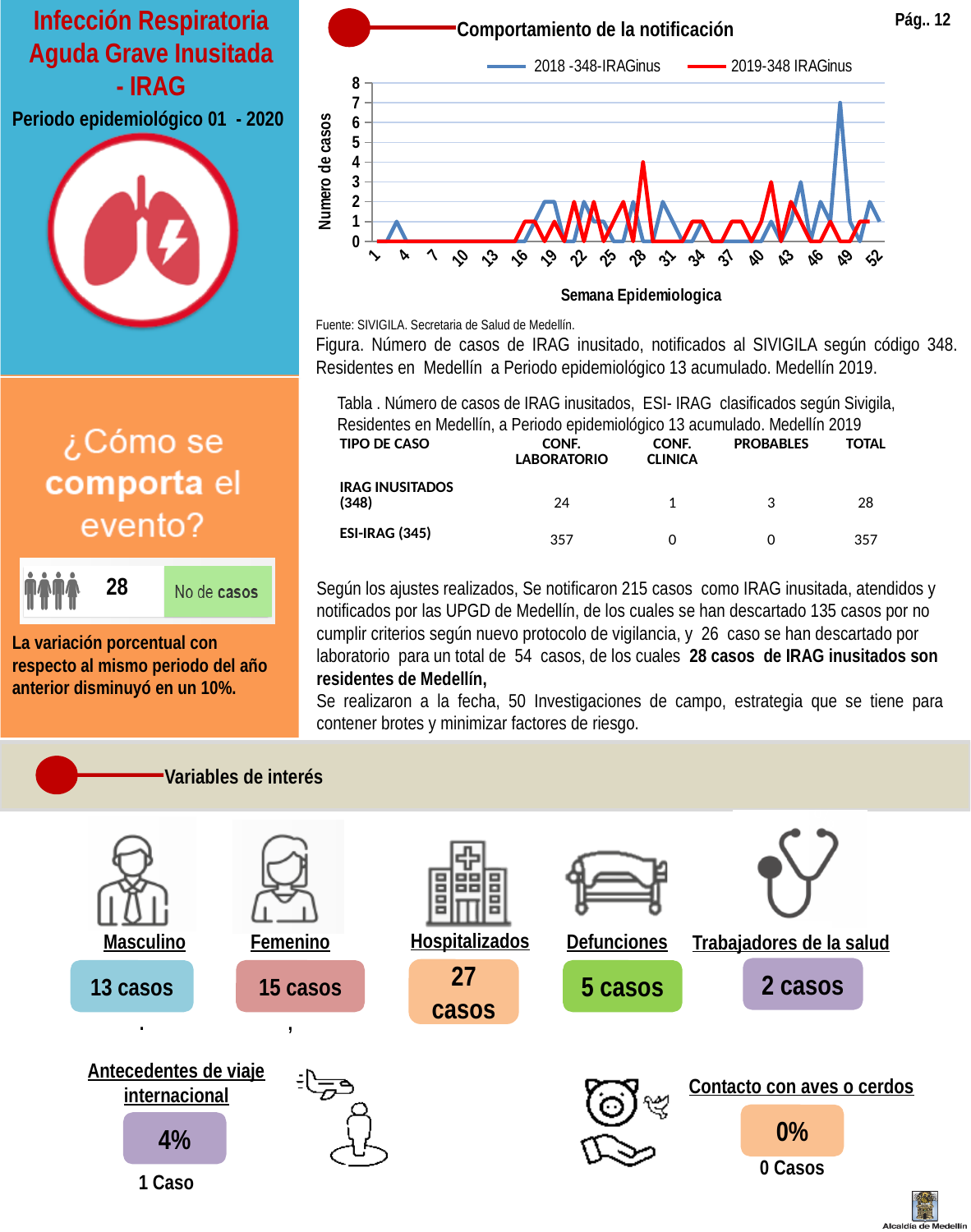
In the 'Comportamiento de la notificación' chart, what is the difference between the peak value of the 2018 series (7) and the peak value of the 2019 series (4)? 3 What kind of chart is 'Comportamiento de la notificación'? line chart How many series does the legend of the 'Comportamiento de la notificación' chart list? 2 In the 'Comportamiento de la notificación' chart, which series reaches the highest number of cases in any week? 2018 -348-IRAGinus In the 'Comportamiento de la notificación' chart, what is the highest number of cases reached by the 2019-348 IRAGinus series? 4 In the 'Comportamiento de la notificación' chart, what is the last epidemiological week shown on the x axis? 52 In the 'Comportamiento de la notificación' chart, is the peak value of the 2018 -348-IRAGinus series greater or less than 5? greater What are the two series named in the legend of the 'Comportamiento de la notificación' chart? 2018 -348-IRAGinus and 2019-348 IRAGinus In the 'Comportamiento de la notificación' chart, around week 49, which series has the higher number of cases? 2018 -348-IRAGinus In the 'Comportamiento de la notificación' chart, what is the highest number of cases reached by the 2018 -348-IRAGinus series? 7 In the 'Comportamiento de la notificación' chart, is the peak value of the 2019-348 IRAGinus series greater or less than 5? less What is the title of the vertical axis of the 'Comportamiento de la notificación' chart? Numero de casos